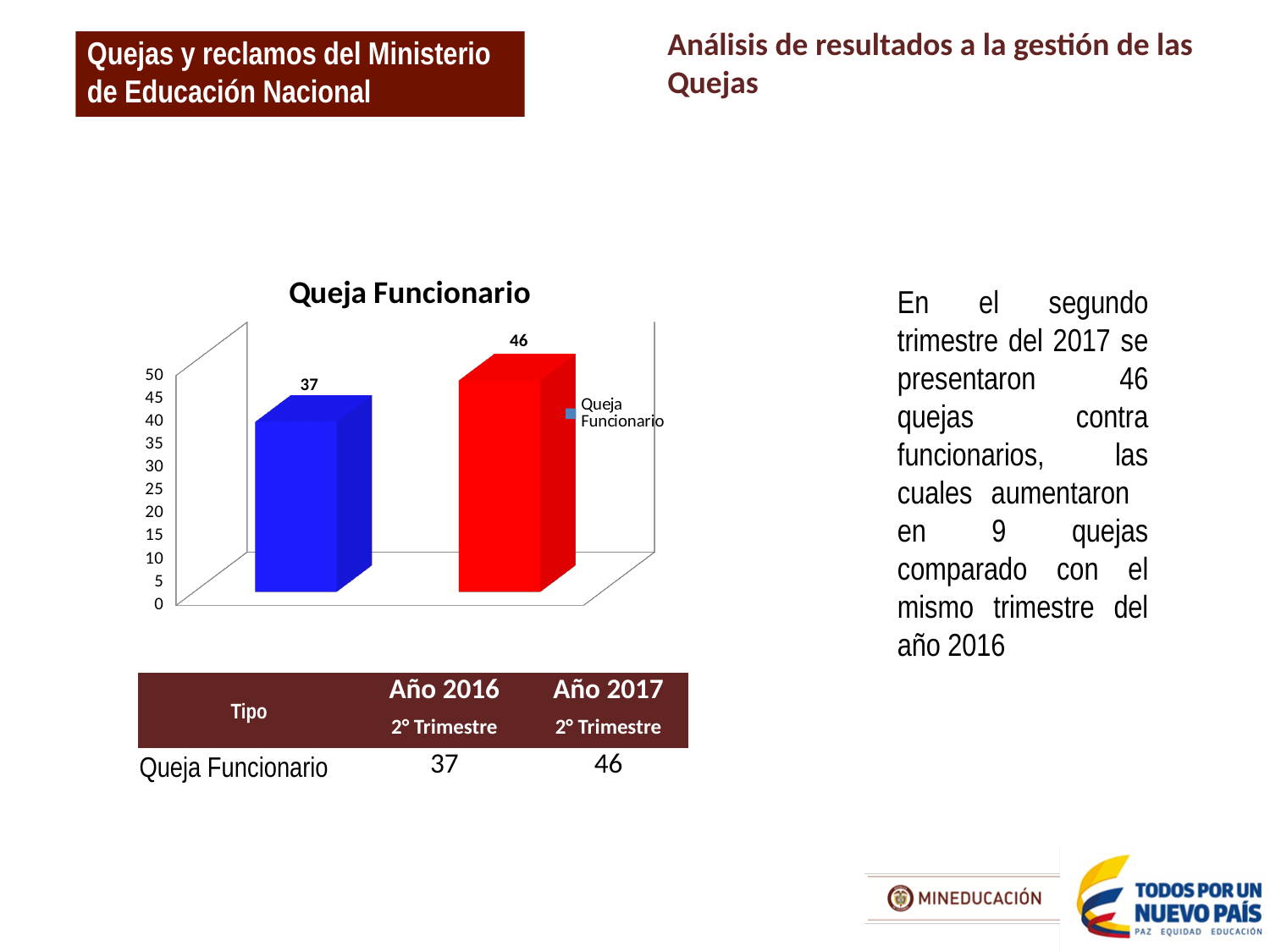
How many entries does the chart legend list? 1 What is the difference between the values of the red bar and the blue bar? 9 Do the values rise or fall from the left bar to the right bar? rise Which bar has the higher value, the blue bar or the red bar? red bar How many bars are plotted in the chart? 2 What is the value shown on the red bar in the chart? 46 What is the title of the chart? Queja Funcionario Which bar shows the lowest value in the chart? the blue bar (37) Is the value of the red bar greater or less than 40? greater What is the value shown on the blue bar in the chart? 37 What type of chart is shown on the slide? bar chart What is the maximum value shown on the chart's vertical axis? 50